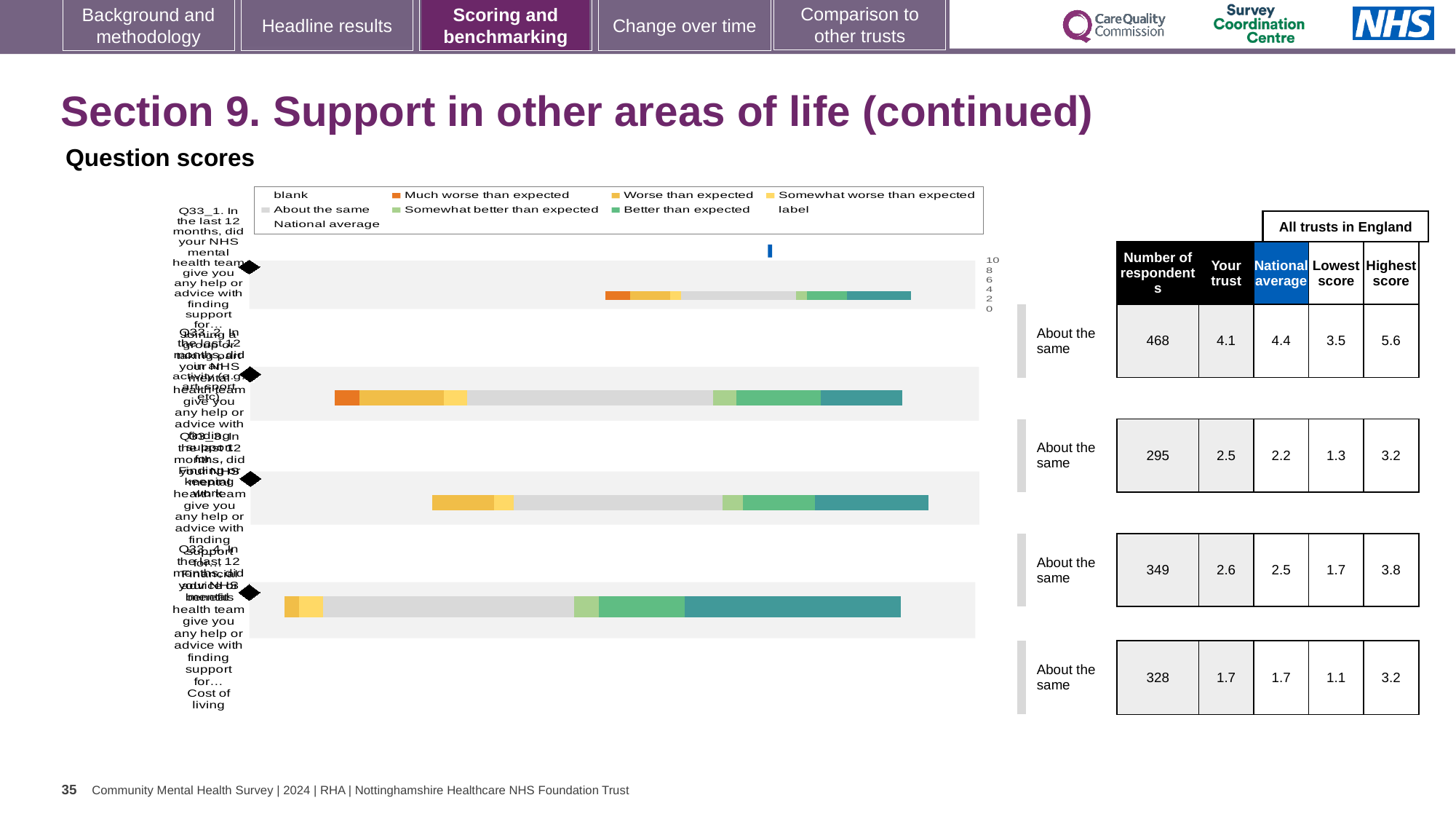
In the table, what is the 'Your trust' score for the first question row (Q33_1)? 4.1 How many question rows (bars) are plotted in the chart? 4 Which question row has the highest number of respondents in the table? Q33_1 (first row), 468 In the table, what is the number of respondents for the first question row (Q33_1)? 468 In the table, what is the national average for the second question row (Q33_2)? 2.2 Which question row has the lowest 'Your trust' score in the table? Q33_4 (fourth row), 1.7 In the table, what is the highest score for the third question row (Q33_3)? 3.8 For the first question row (Q33_1), what is the difference between the national average and the 'Your trust' score? 0.3 What kind of chart is shown on the slide? bar chart In the table, what is the lowest score for the fourth question row (Q33_4, Cost of living)? 1.1 For the second question row (Q33_2), which is larger: the 'Your trust' score or the national average? Your trust How many entries does the chart legend list? 9